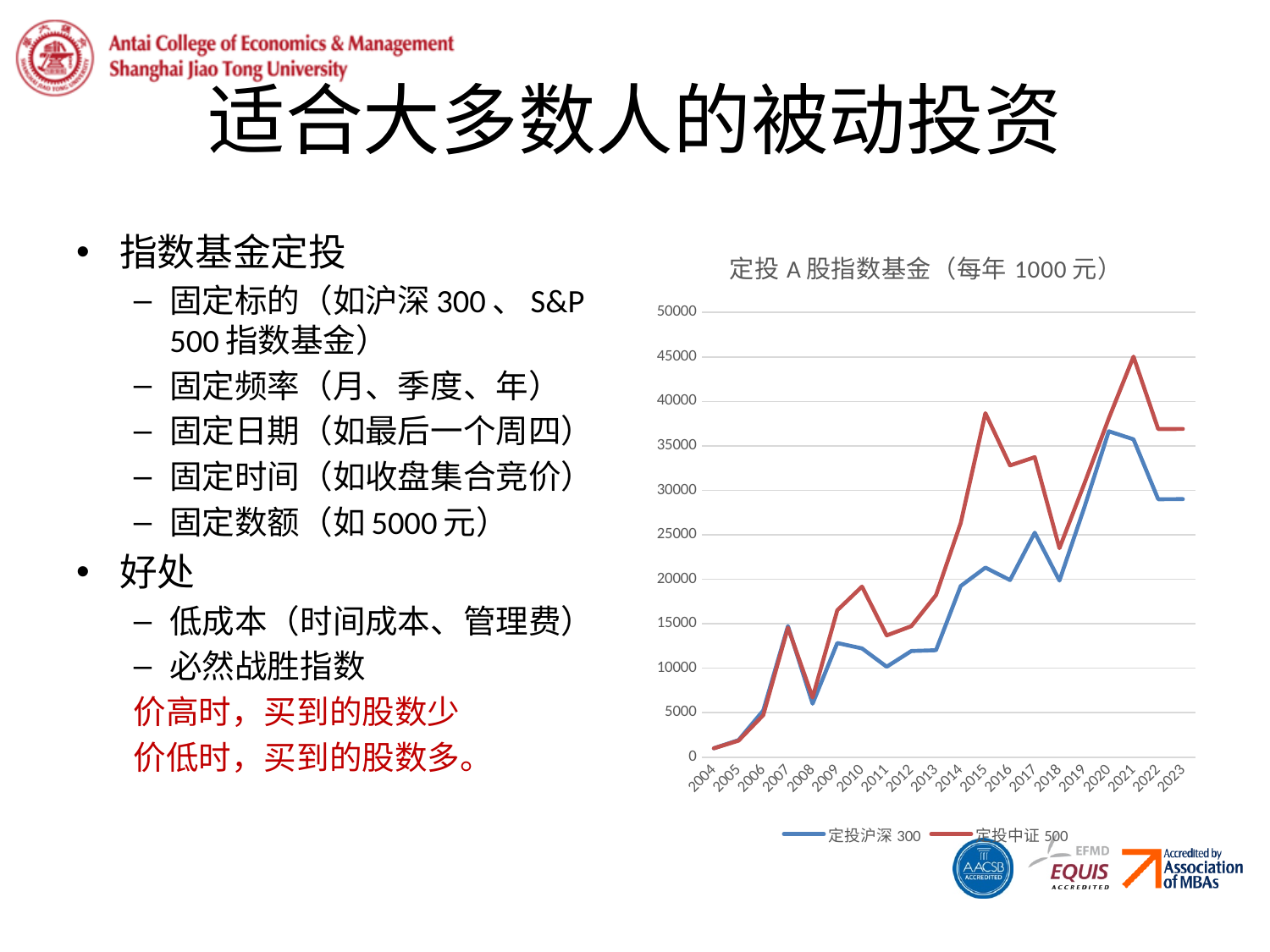
Is the value for 定投中证 500 in 2015 greater or less than 35000? greater Is the value for 定投沪深 300 in 2023 greater or less than 30000? less In which year does the 定投中证 500 series reach its highest value? 2021 What kind of chart is shown on the slide? line chart How many series does the chart legend list? 2 In 2023, which series has the larger value, 定投沪深 300 or 定投中证 500? 定投中证 500 How many years are plotted along the x axis of the chart? 20 Which series is drawn in red in the chart? 定投中证 500 In which year is the 定投沪深 300 series at its lowest value? 2004 Is the value for 定投中证 500 in 2008 greater or less than 10000? less What is the title of the chart? 定投 A 股指数基金（每年 1000 元） In which year does the 定投沪深 300 series reach its highest value? 2020